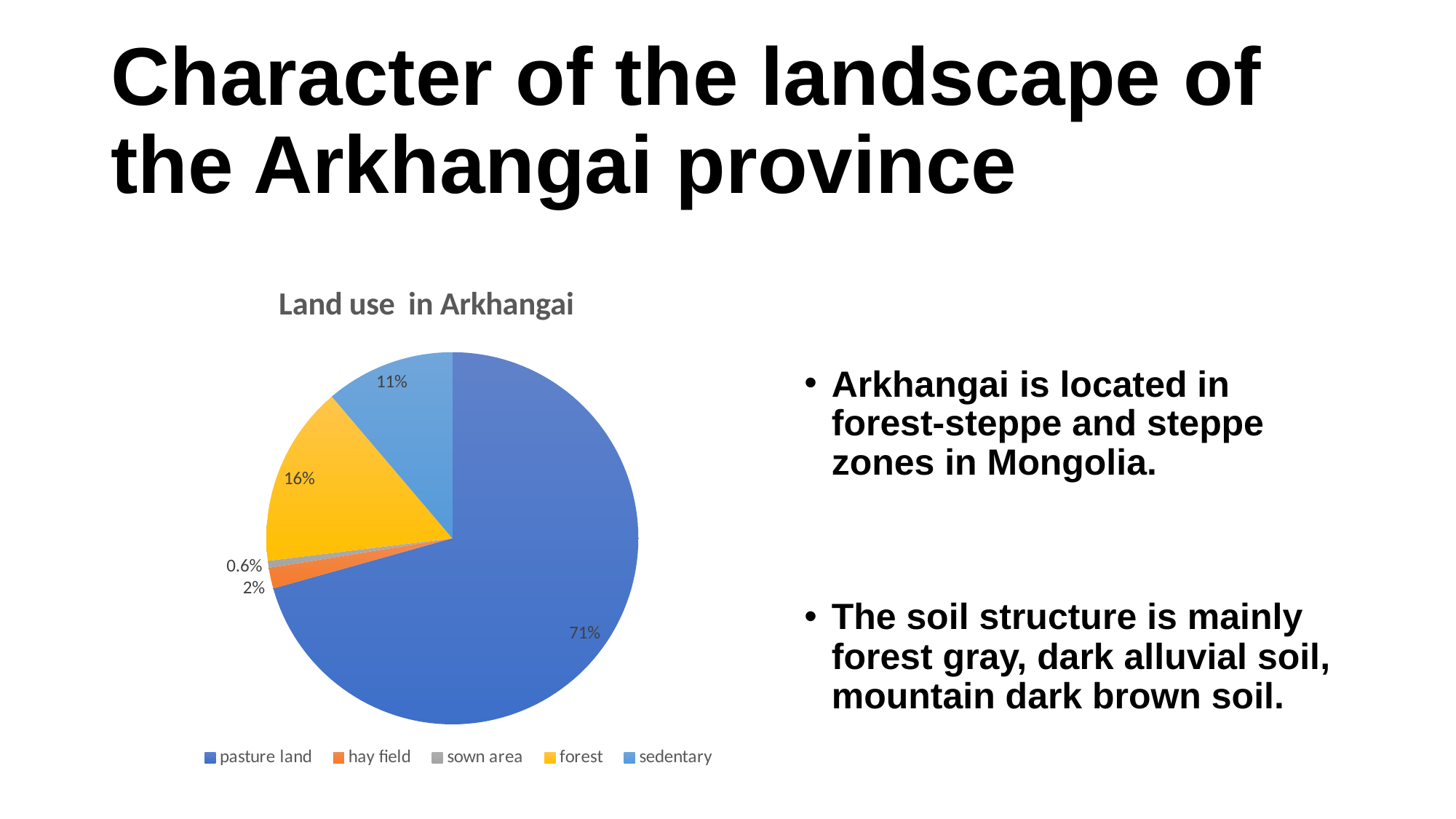
What share of land use is forest? 16% How many categories does the pie chart show? 5 What type of chart is shown on the slide? pie chart Which land use category has the largest share? pasture land What share of land use is hay field? 2% What share of land use is pasture land? 71% What is the difference in share between pasture land and forest? 55% Which has a larger share, forest or sedentary? forest Which land use category has the smallest share? sown area What share of land use is sedentary? 11% What is the title of the chart? Land use in Arkhangai What share of land use is sown area? 0.6%